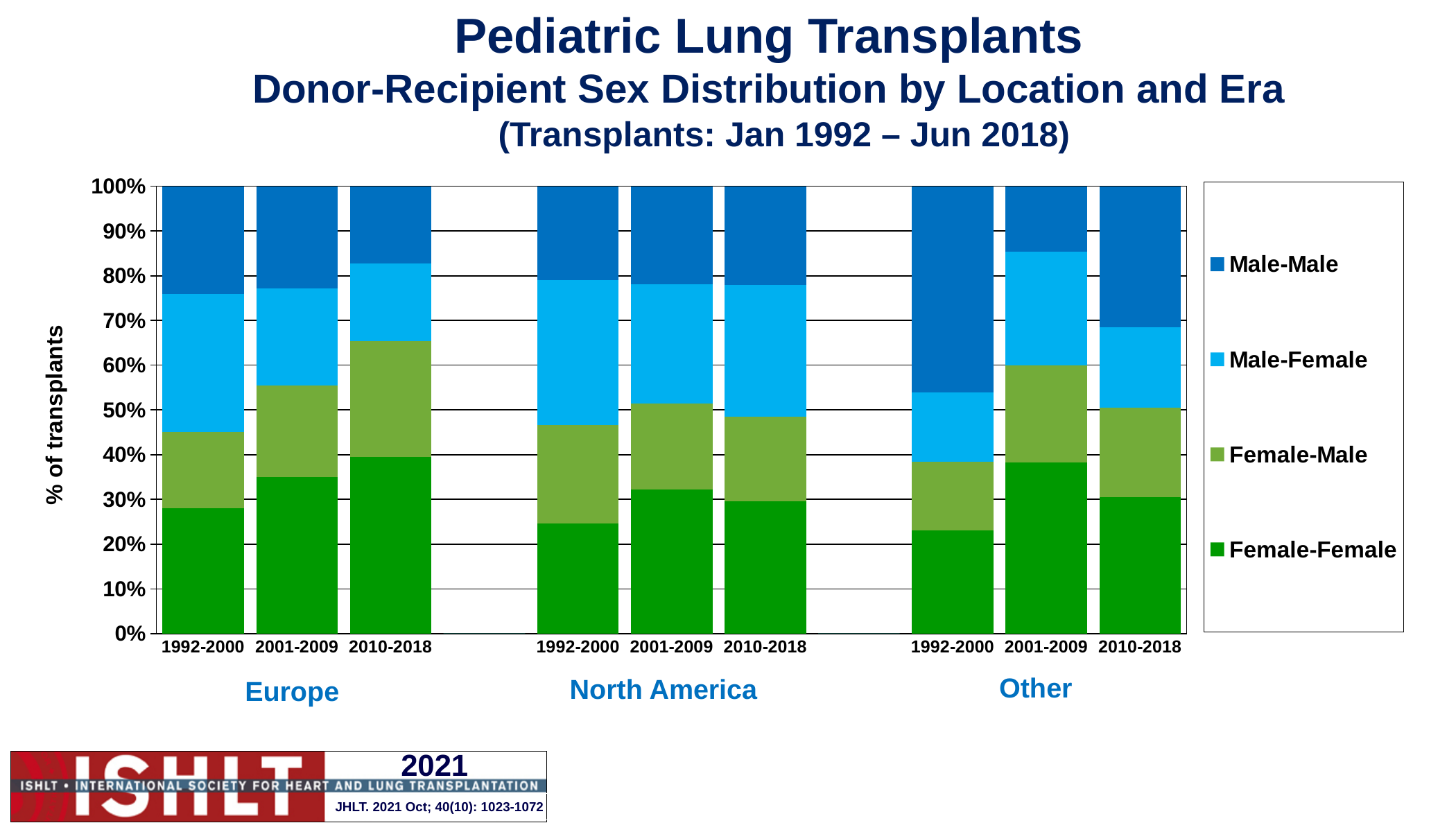
Does the Female-Female share in Europe rise or fall across the three eras? rise How many regions are shown along the x axis? 3 What kind of chart is shown on the slide? stacked bar chart How many bars are plotted in the chart? 9 For the Other region, is the Male-Male segment larger in 1992-2000 or in 2001-2009? 1992-2000 Is the Female-Female share for Other in 2001-2009 greater or less than 30%? greater Is the Female-Female share for Europe in 2010-2018 greater or less than 30%? greater How many series does the legend list? 4 Is the Female-Female share for Other in 1992-2000 greater or less than 30%? less What is the label on the y axis? % of transplants Which bar has the largest Male-Male segment? Other 1992-2000